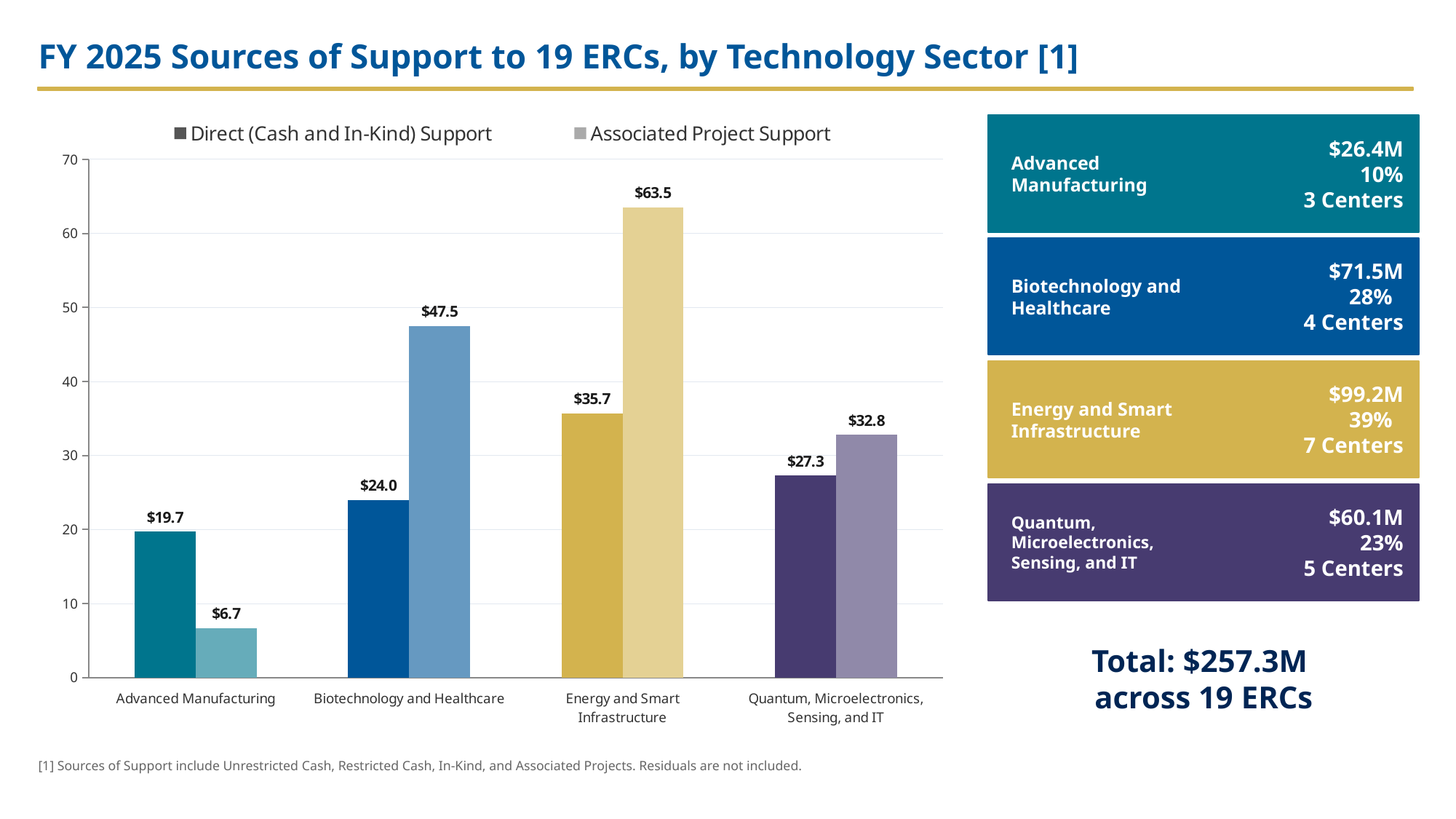
Which technology sector has the lowest Associated Project Support? Advanced Manufacturing What is the Associated Project Support value for Biotechnology and Healthcare? $47.5 What kind of chart is shown on the slide? Bar chart What is the Direct (Cash and In-Kind) Support value for Advanced Manufacturing? $19.7 What is the difference between Associated Project Support and Direct (Cash and In-Kind) Support for Biotechnology and Healthcare? $23.5 What is the Direct (Cash and In-Kind) Support value for Quantum, Microelectronics, Sensing, and IT? $27.3 For Advanced Manufacturing, which is larger: Direct (Cash and In-Kind) Support or Associated Project Support? Direct (Cash and In-Kind) Support How many technology sectors are shown on the x axis of the chart? 4 What is the Associated Project Support value for Energy and Smart Infrastructure? $63.5 Is the Direct (Cash and In-Kind) Support value for Energy and Smart Infrastructure greater or less than 30? greater How many series does the chart legend list? 2 Which technology sector has the highest Associated Project Support? Energy and Smart Infrastructure